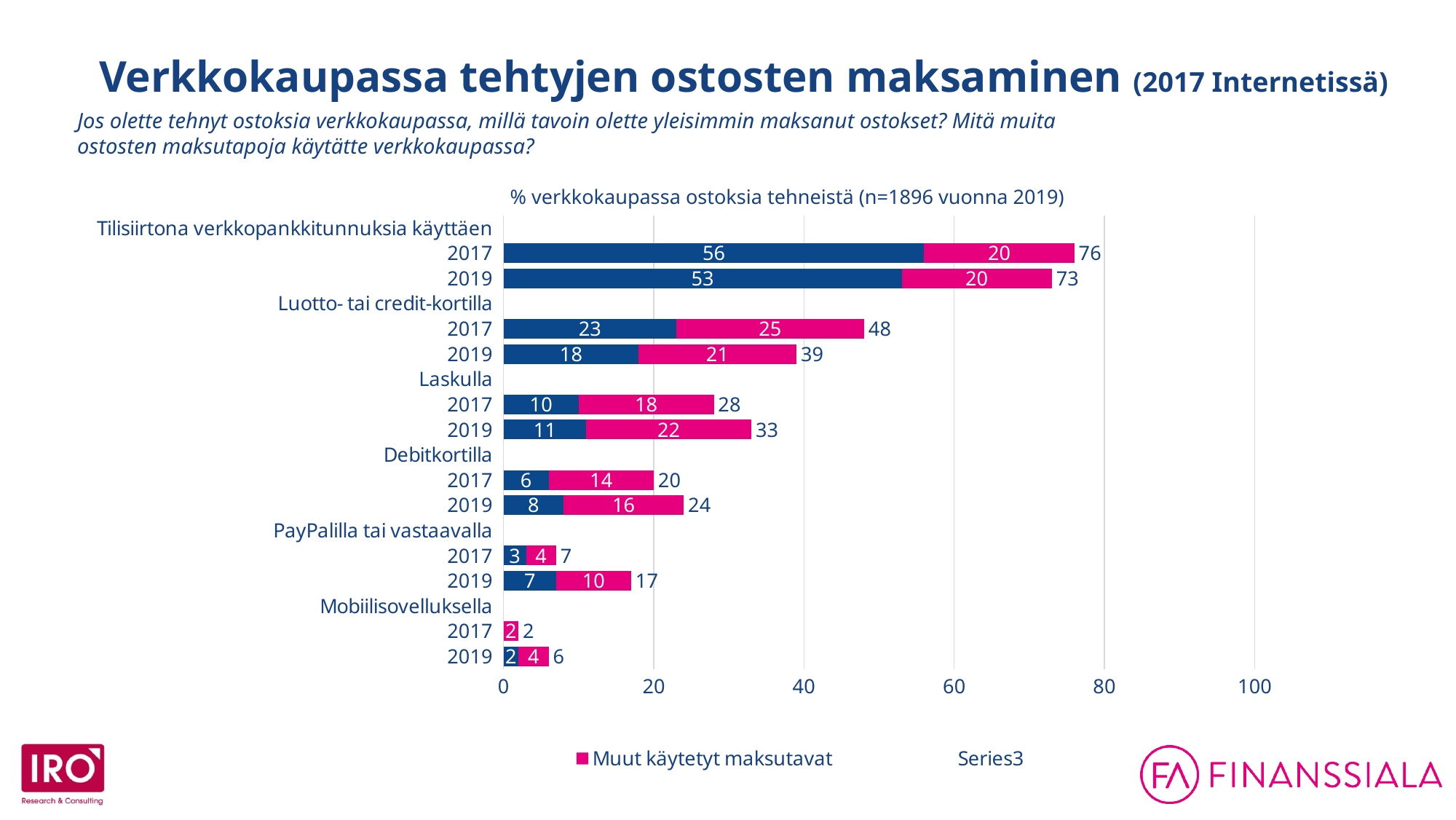
What is the difference between the 2017 and 2019 totals for Luotto- tai credit-kortilla? 9 What is the label of the pink series in the legend? Muut käytetyt maksutavat What is the value of the blue segment for Laskulla in 2019? 11 How many payment methods are listed on the chart? 6 What is the total of the stacked bar for Debitkortilla in 2019? 24 Which payment method has the lowest total bar in 2019? Mobiilisovelluksella What kind of chart is shown on the slide? Stacked bar chart What is the value of the 'Muut käytetyt maksutavat' segment for Luotto- tai credit-kortilla in 2017? 25 What is the total shown at the end of the bar for Tilisiirtona verkkopankkitunnuksia käyttäen in 2019? 73 Is the 2017 total for Laskulla greater or less than 20? greater Which is larger, the 2017 total or the 2019 total for PayPalilla tai vastaavalla? 2019 Which payment method has the highest total bar in 2017? Tilisiirtona verkkopankkitunnuksia käyttäen